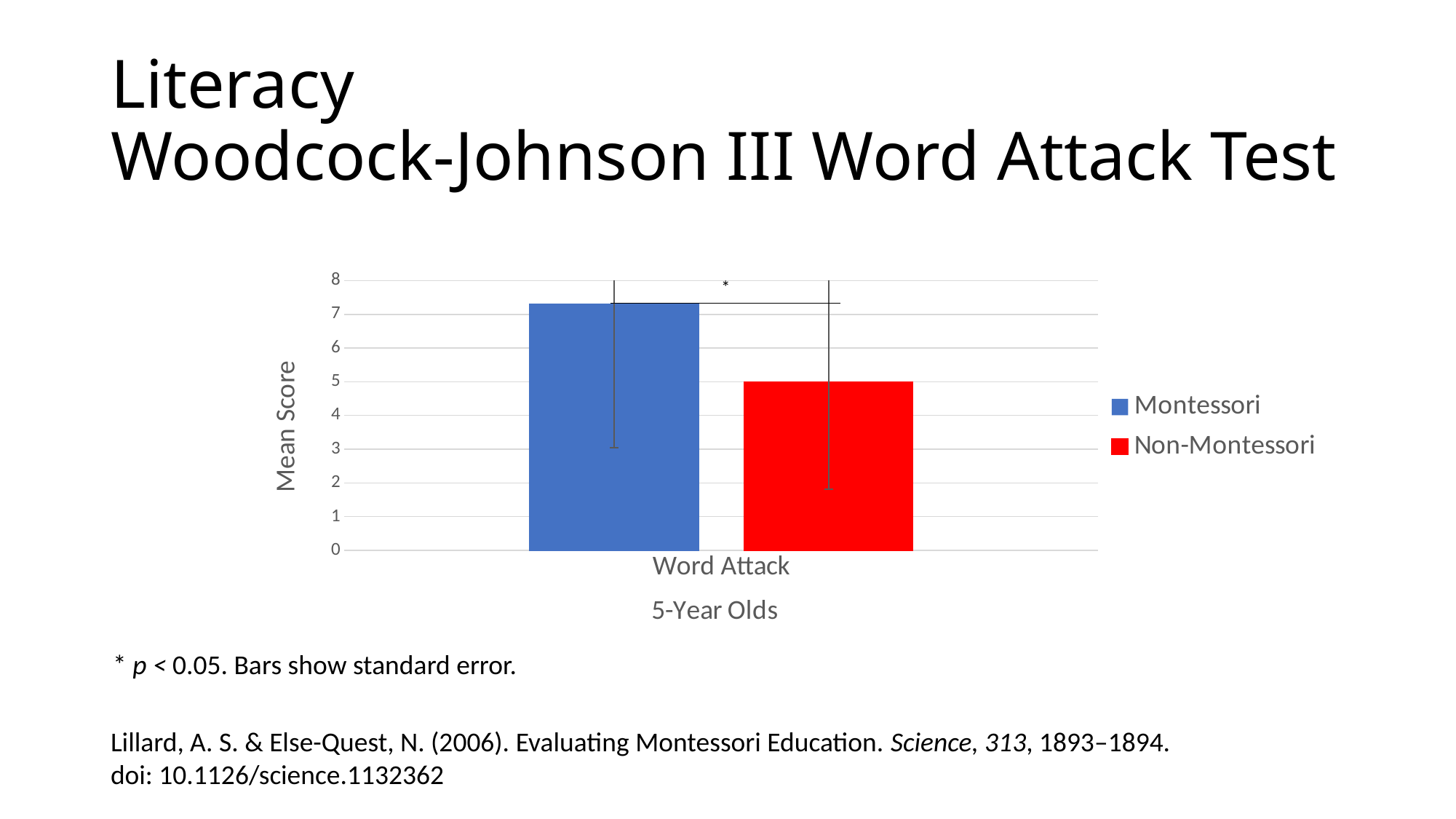
Which group has the higher mean Word Attack score, Montessori or Non-Montessori? Montessori What is the label of the y axis? Mean Score What colour is the Non-Montessori bar? red What kind of chart is shown on the slide? bar chart Which series has the highest bar in the chart? Montessori How many series does the legend list? 2 Is the mean score for Non-Montessori greater or less than 6? less Which series has the lowest bar in the chart? Non-Montessori How many categories are shown on the x axis? 1 Is the mean score for Montessori greater or less than 8? less Is the mean score for Montessori greater or less than 7? greater